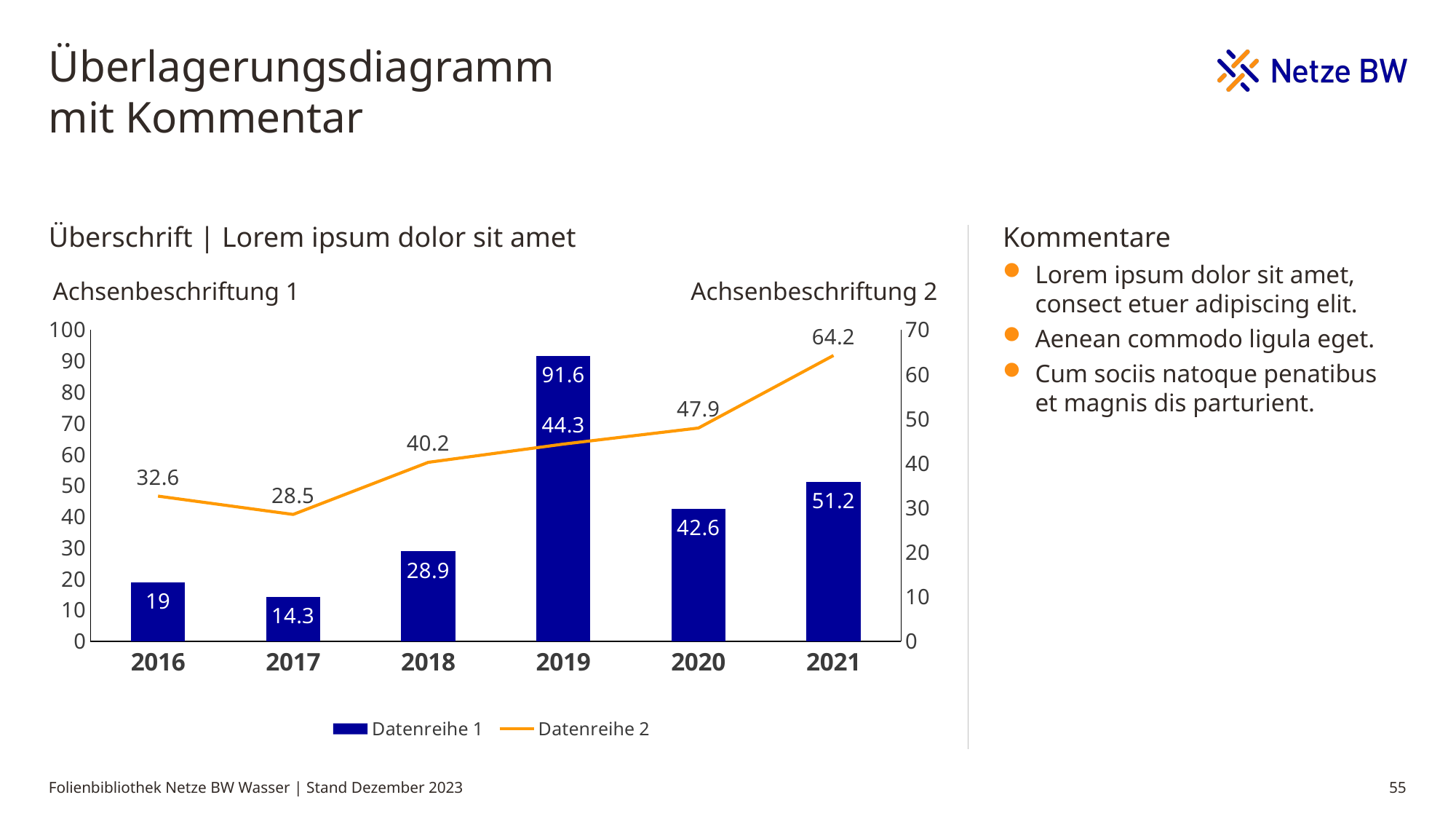
Which is larger: the Datenreihe 2 value for 2018 or for 2016? 2018 What is the value of Datenreihe 1 for 2019? 91.6 What is the value of Datenreihe 1 for 2017? 14.3 How many years are shown on the x axis? 6 Which year has the highest value for Datenreihe 1? 2019 What is the label of the right-hand axis? Achsenbeschriftung 2 What is the difference between the Datenreihe 1 values for 2021 and 2020? 8.6 What kind of chart is shown on the slide? Combined bar and line chart Which year has the lowest value for Datenreihe 2? 2017 What is the value of Datenreihe 2 for 2021? 64.2 How many series does the legend list? 2 Does Datenreihe 2 rise or fall from 2017 to 2021? Rise